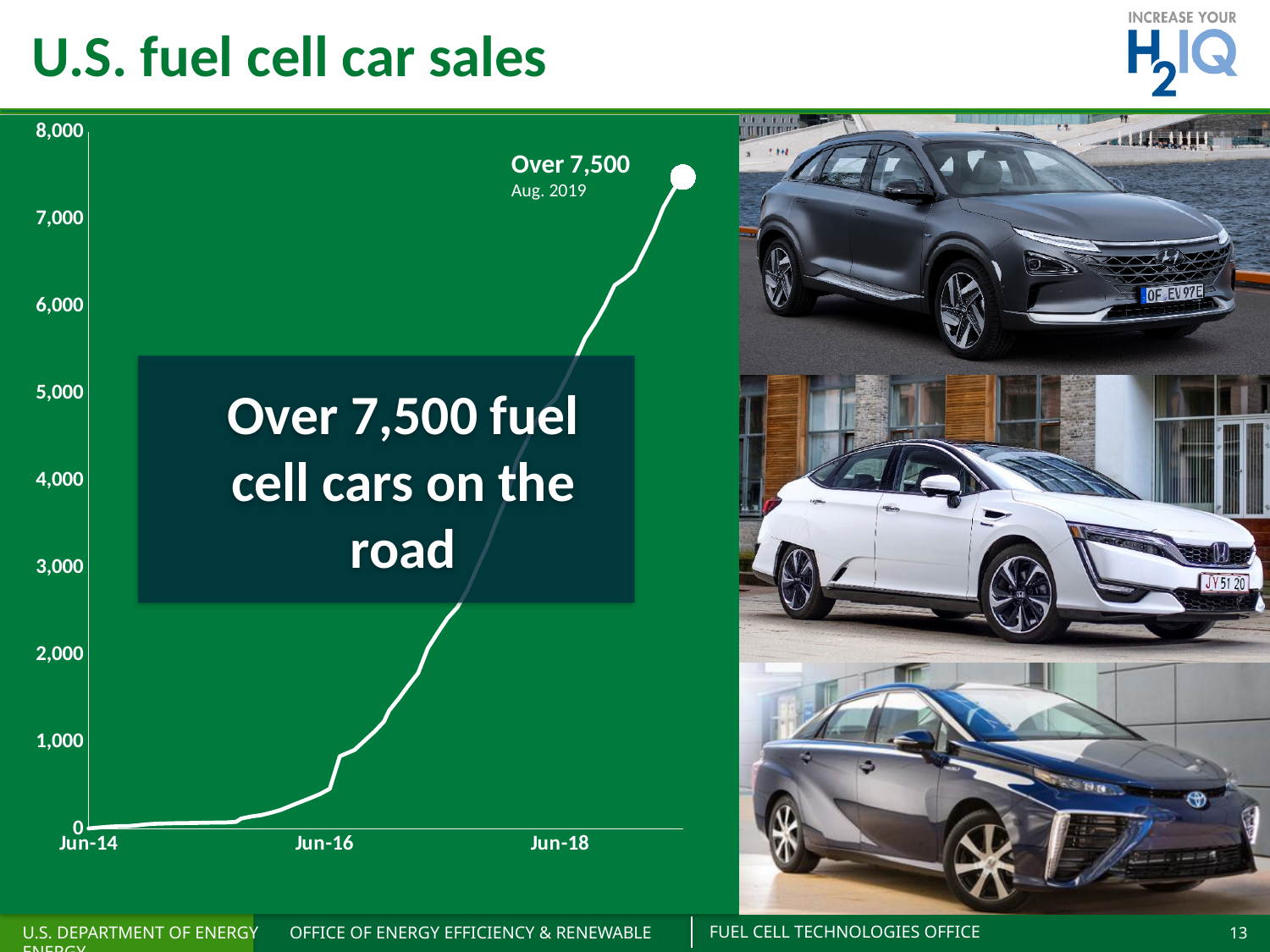
Is the value at Jun-18 greater or less than 4,000? greater What is the highest value shown on the vertical axis? 8,000 How many date labels are shown on the horizontal axis? 3 Is the value at Jun-14 greater or less than 1,000? less At which labelled date is the value lowest? Jun-14 What is the title of the chart? U.S. fuel cell car sales What kind of chart is shown on the slide? line chart What value is labelled at the final point of the line? Over 7,500 Which is larger, the value at Jun-16 or the value at Jun-18? Jun-18 What date is given for the final labelled point on the line? Aug. 2019 Is the value at Jun-16 greater or less than 1,000? less Do the values rise or fall from Jun-14 to Aug. 2019? rise